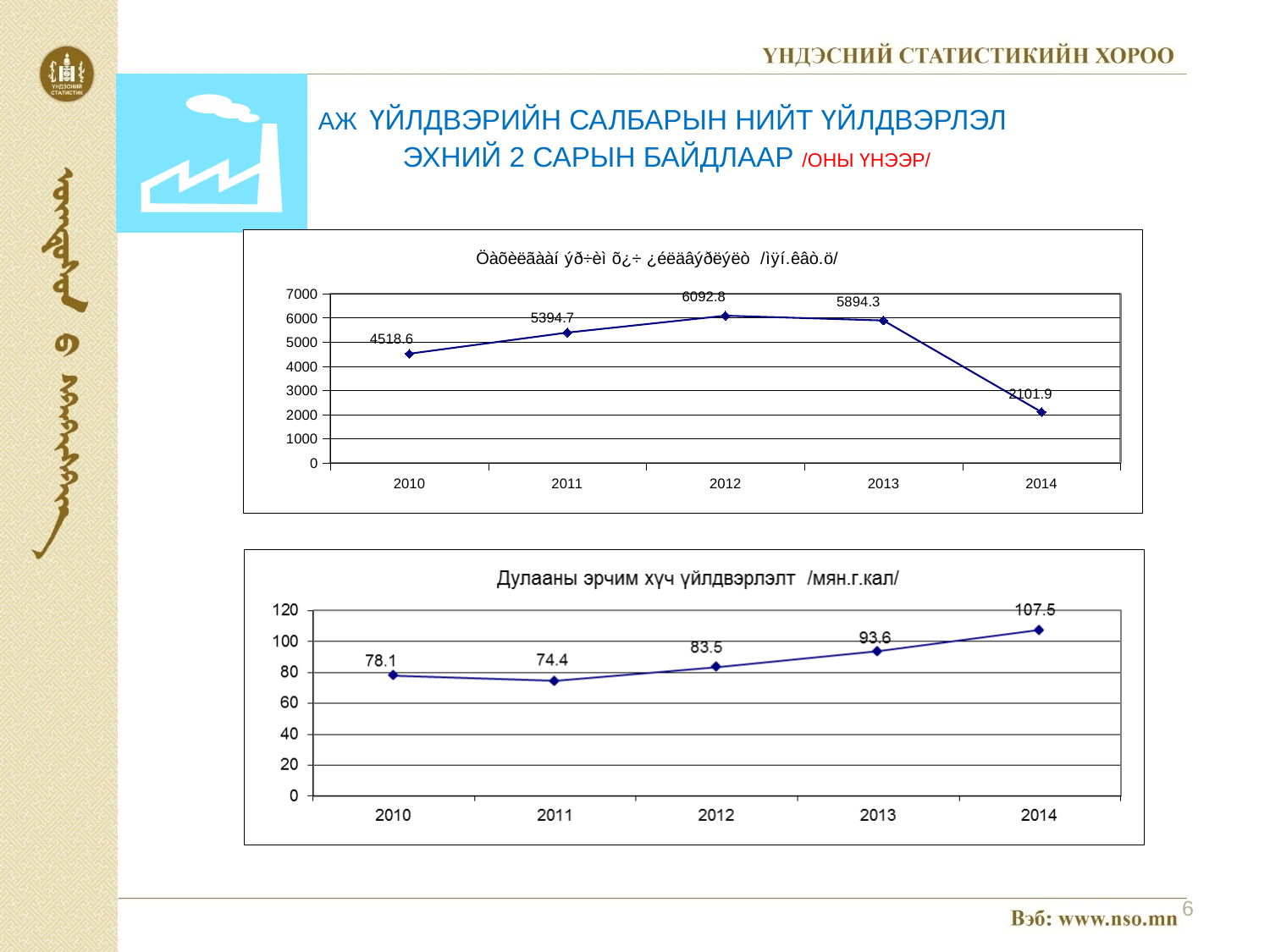
What kind of chart is the bottom chart titled 'Дулааны эрчим хүч үйлдвэрлэлт /мян.г.кал/'? Line chart In the bottom chart titled 'Дулааны эрчим хүч үйлдвэрлэлт /мян.г.кал/', what is the value for 2013? 93.6 In the bottom chart titled 'Дулааны эрчим хүч үйлдвэрлэлт /мян.г.кал/', is the value for 2012 larger than the value for 2011? Yes In the top chart, what is the value for 2012? 6092.8 In the bottom chart titled 'Дулааны эрчим хүч үйлдвэрлэлт /мян.г.кал/', which year has the highest value? 2014 In the top chart, what is the difference between the values for 2011 and 2010? 876.1 In the bottom chart titled 'Дулааны эрчим хүч үйлдвэрлэлт /мян.г.кал/', which year has the lowest value? 2011 In the top chart, how many data points are plotted? 5 In the top chart, which year has the highest value? 2012 In the top chart, which year has the lowest value? 2014 In the top chart, what is the value for 2014? 2101.9 In the bottom chart titled 'Дулааны эрчим хүч үйлдвэрлэлт /мян.г.кал/', what is the difference between the values for 2014 and 2010? 29.4